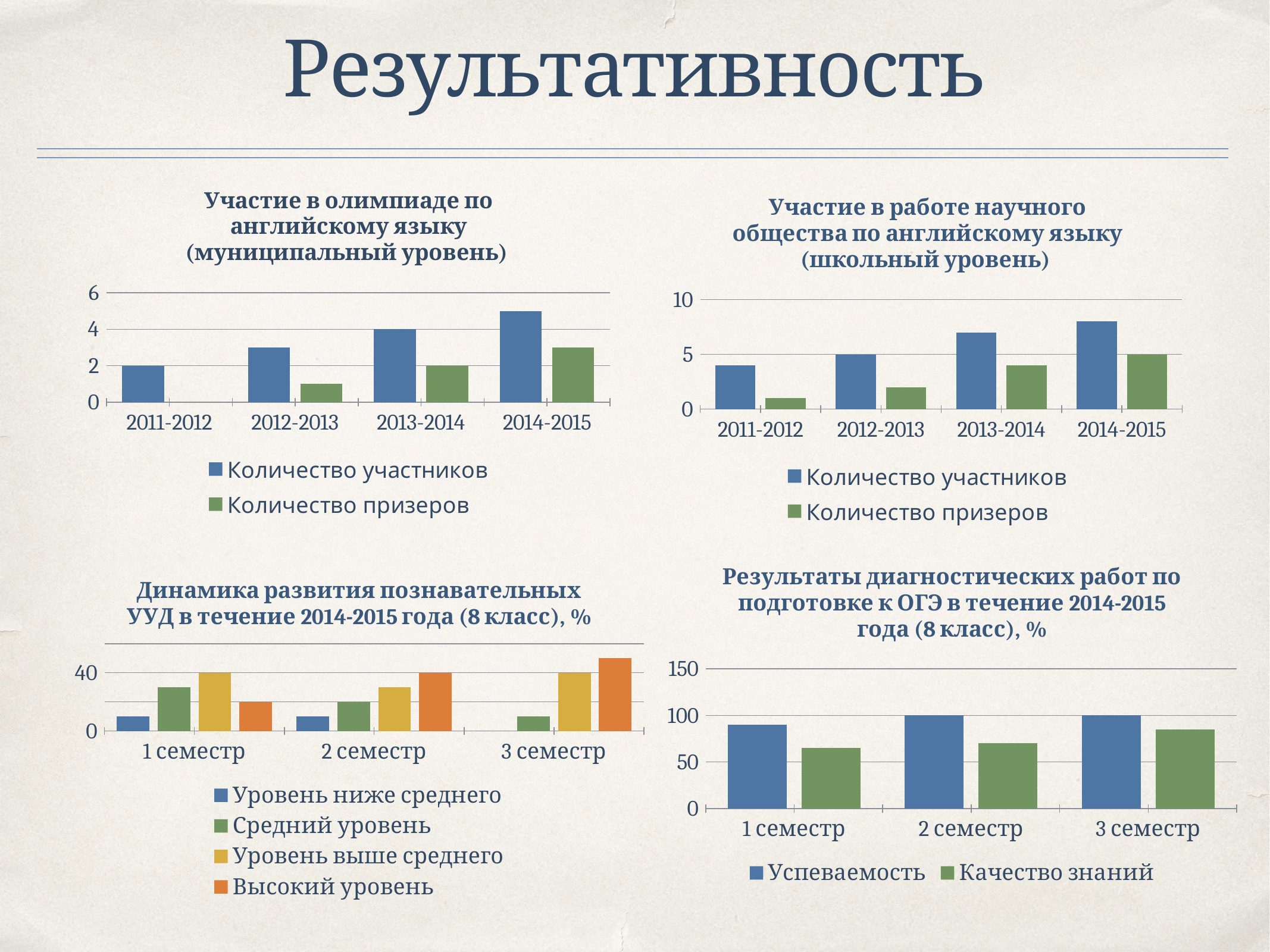
How many series does the legend of the chart 'Динамика развития познавательных УУД в течение 2014-2015 года (8 класс), %' list? 4 In the chart 'Результаты диагностических работ по подготовке к ОГЭ в течение 2014-2015 года (8 класс), %', what is the value of 'Успеваемость' for 2 семестр? 100 In the chart 'Участие в работе научного общества по английскому языку (школьный уровень)', which year has the lowest 'Количество призеров'? 2011-2012 In the chart 'Участие в работе научного общества по английскому языку (школьный уровень)', is the value of 'Количество участников' for 2014-2015 greater or less than 5? greater In the chart 'Результаты диагностических работ по подготовке к ОГЭ в течение 2014-2015 года (8 класс), %', which is larger for 1 семестр: 'Успеваемость' or 'Качество знаний'? Успеваемость In the chart 'Участие в олимпиаде по английскому языку (муниципальный уровень)', what is the value of 'Количество участников' for 2013-2014? 4 What kind of chart is 'Участие в олимпиаде по английскому языку (муниципальный уровень)'? bar chart How many year categories are shown on the x axis of the chart 'Участие в работе научного общества по английскому языку (школьный уровень)'? 4 In the chart 'Участие в работе научного общества по английскому языку (школьный уровень)', what is the value of 'Количество участников' for 2012-2013? 5 In the chart 'Участие в олимпиаде по английскому языку (муниципальный уровень)', do the values of 'Количество участников' rise or fall from 2011-2012 to 2014-2015? rise In the chart 'Участие в олимпиаде по английскому языку (муниципальный уровень)', which year has the highest 'Количество участников'? 2014-2015 In the chart 'Участие в олимпиаде по английскому языку (муниципальный уровень)', what is the value of 'Количество участников' for 2011-2012? 2